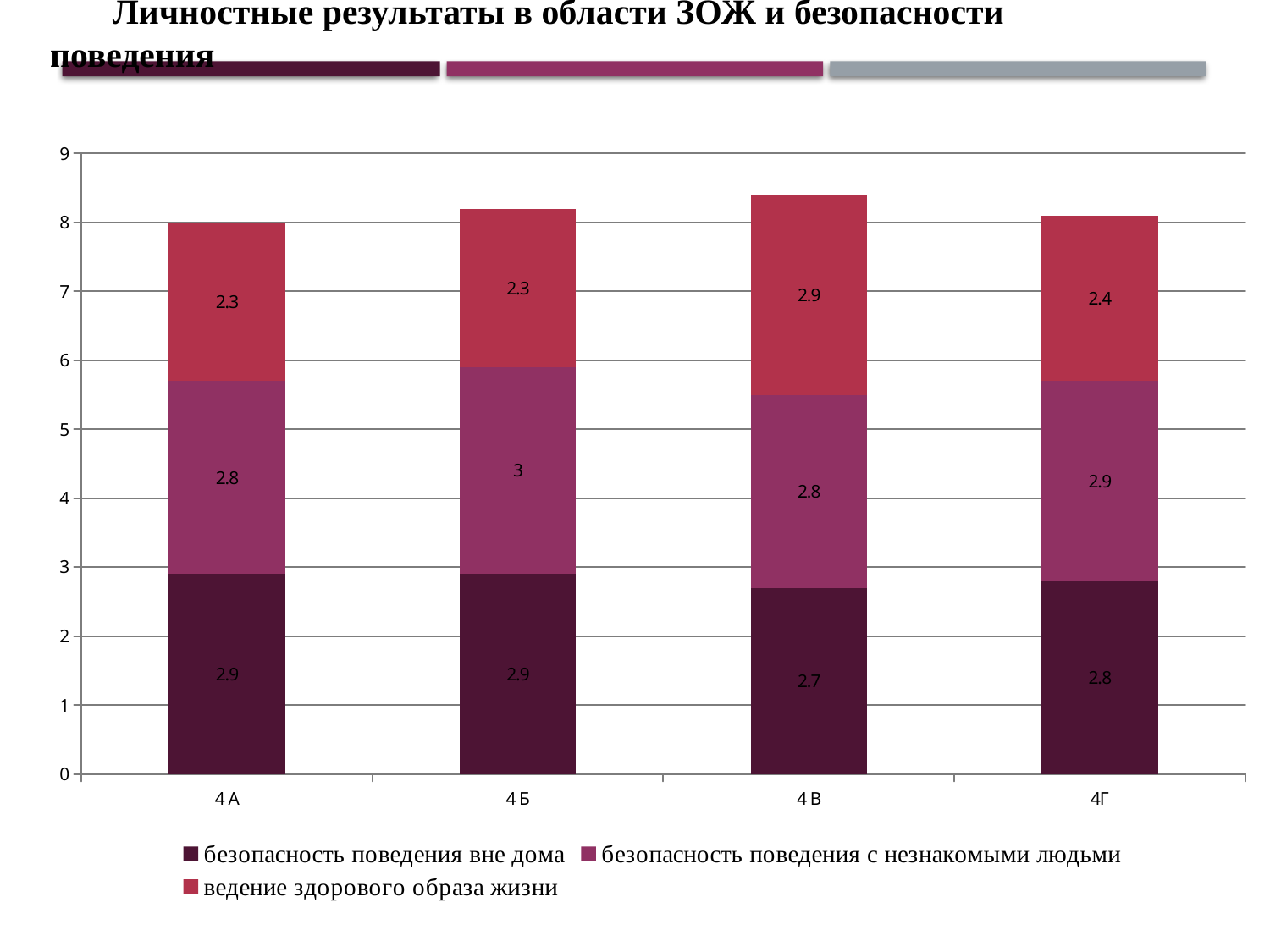
How many series does the legend list? 3 What is the value of 'ведение здорового образа жизни' for 4Г? 2.4 What kind of chart is shown on the slide? stacked bar chart What is the difference between the 'ведение здорового образа жизни' values for 4 В and 4 А? 0.6 Which class has the lowest value for 'безопасность поведения вне дома'? 4 В What is the total of the stacked bar for 4 В? 8.4 What is the value of 'безопасность поведения вне дома' for 4 В? 2.7 Which class has the highest value for 'ведение здорового образа жизни'? 4 В How many categories (classes) are shown on the x axis? 4 What is the value of 'безопасность поведения с незнакомыми людьми' for 4 Б? 3 What is the total of the stacked bar for 4 А? 8 Which is larger: 'безопасность поведения с незнакомыми людьми' for 4Г or for 4 А? 4Г